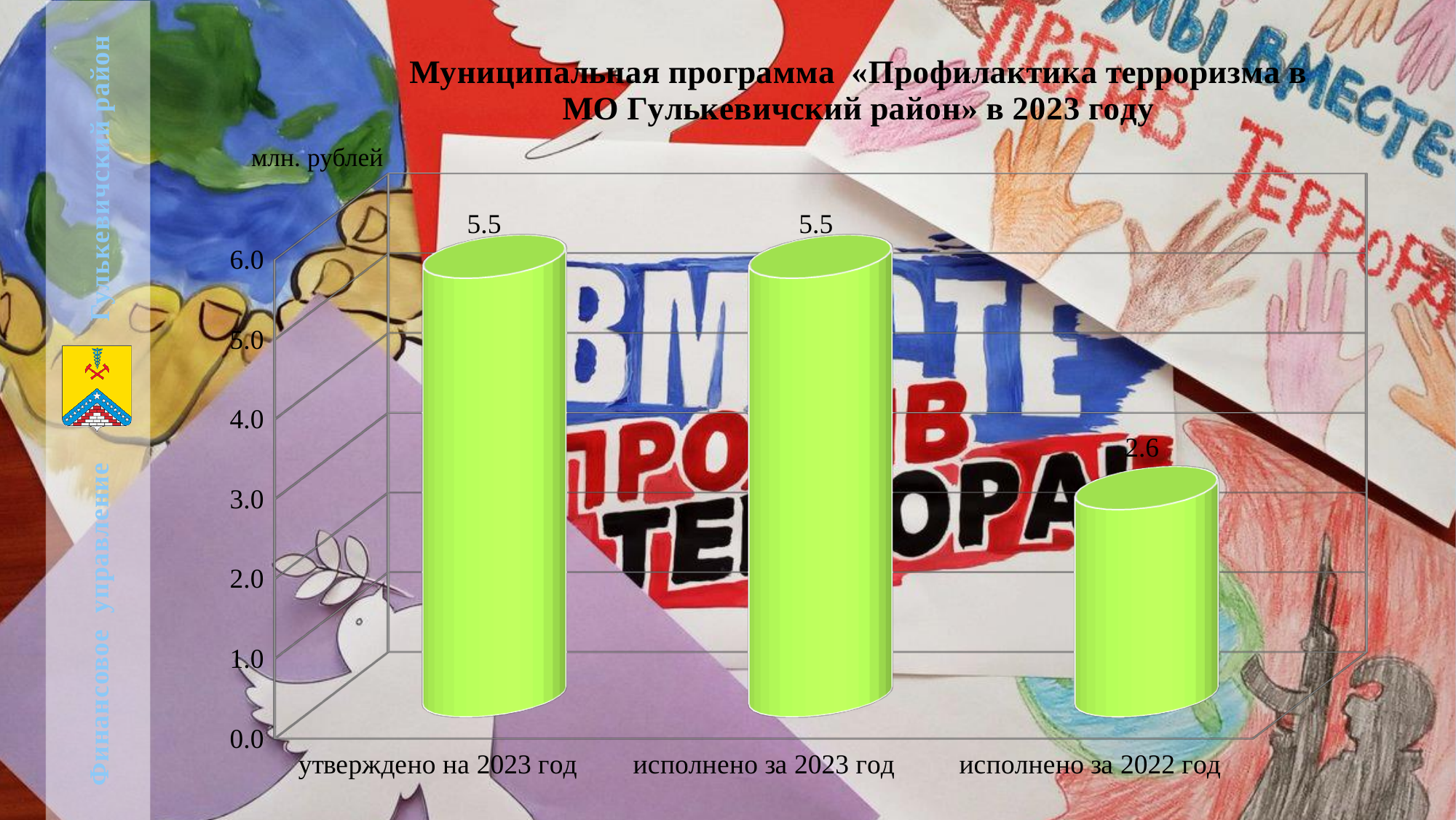
What is the value for «утверждено на 2023 год»? 5.5 How many categories are shown on the chart? 3 What is the difference between «исполнено за 2023 год» and «исполнено за 2022 год»? 2.9 What is the value for «исполнено за 2022 год»? 2.6 What is the value for «исполнено за 2023 год»? 5.5 Which is larger: «утверждено на 2023 год» or «исполнено за 2022 год»? утверждено на 2023 год What kind of chart is shown on the slide? bar chart What unit of measurement is indicated above the vertical axis? млн. рублей Is the value for «исполнено за 2023 год» greater or less than 5.0? greater Which category has the lowest value? исполнено за 2022 год Is the value for «исполнено за 2022 год» greater or less than 3.0? less What is the highest tick value shown on the vertical axis? 6.0